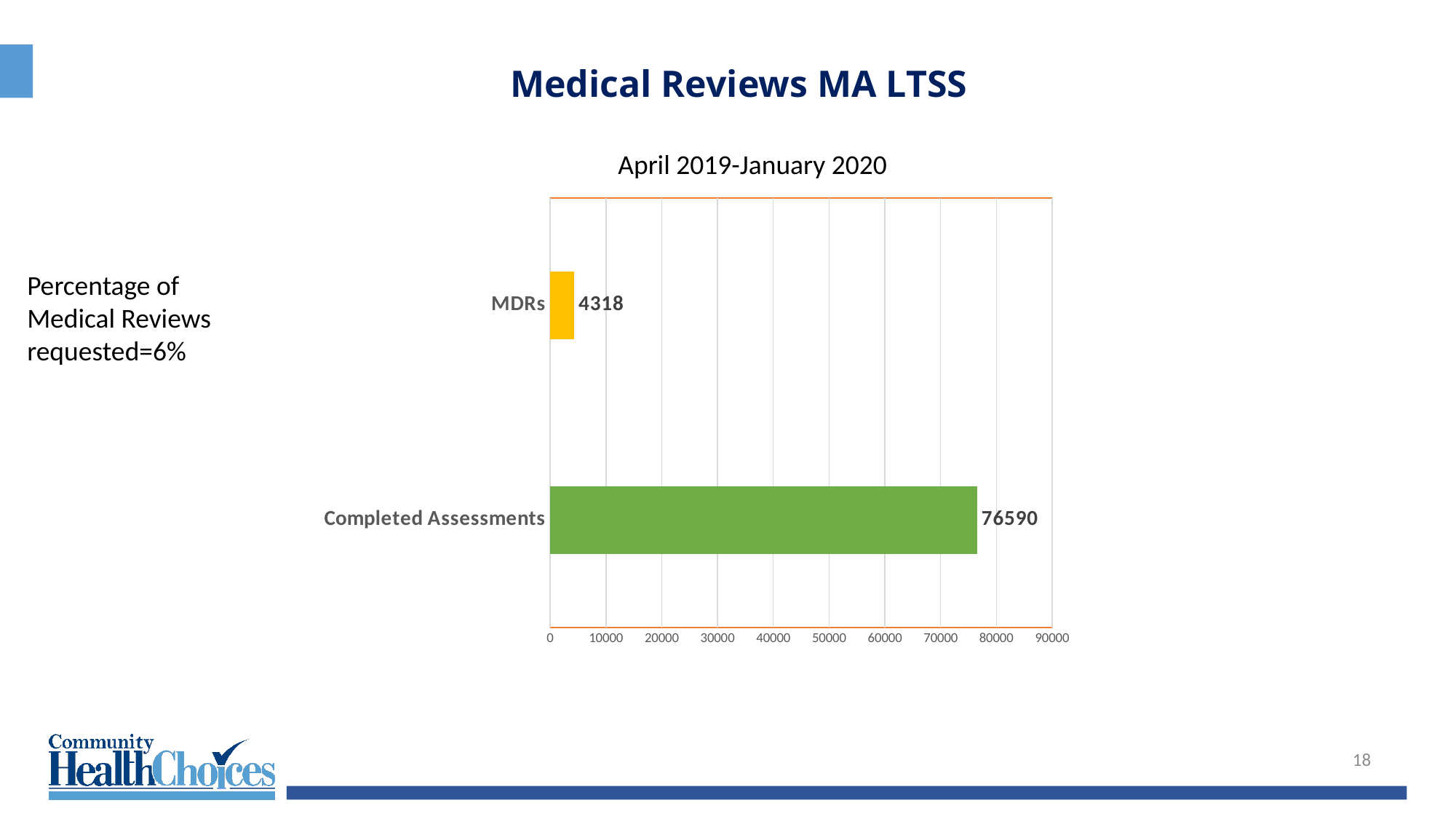
Which category has the highest value? Completed Assessments Is the value for Completed Assessments greater or less than 70000? greater Which category has the lowest value? MDRs Is the value for MDRs greater or less than 10000? less What is the value for Completed Assessments? 76590 Which is larger, the value for MDRs or the value for Completed Assessments? Completed Assessments What is the value for MDRs? 4318 What is the title of the chart? April 2019-January 2020 What is the difference between Completed Assessments and MDRs? 72272 How many categories are shown in the chart? 2 What colour is the bar for MDRs? yellow What kind of chart is shown on the slide? bar chart